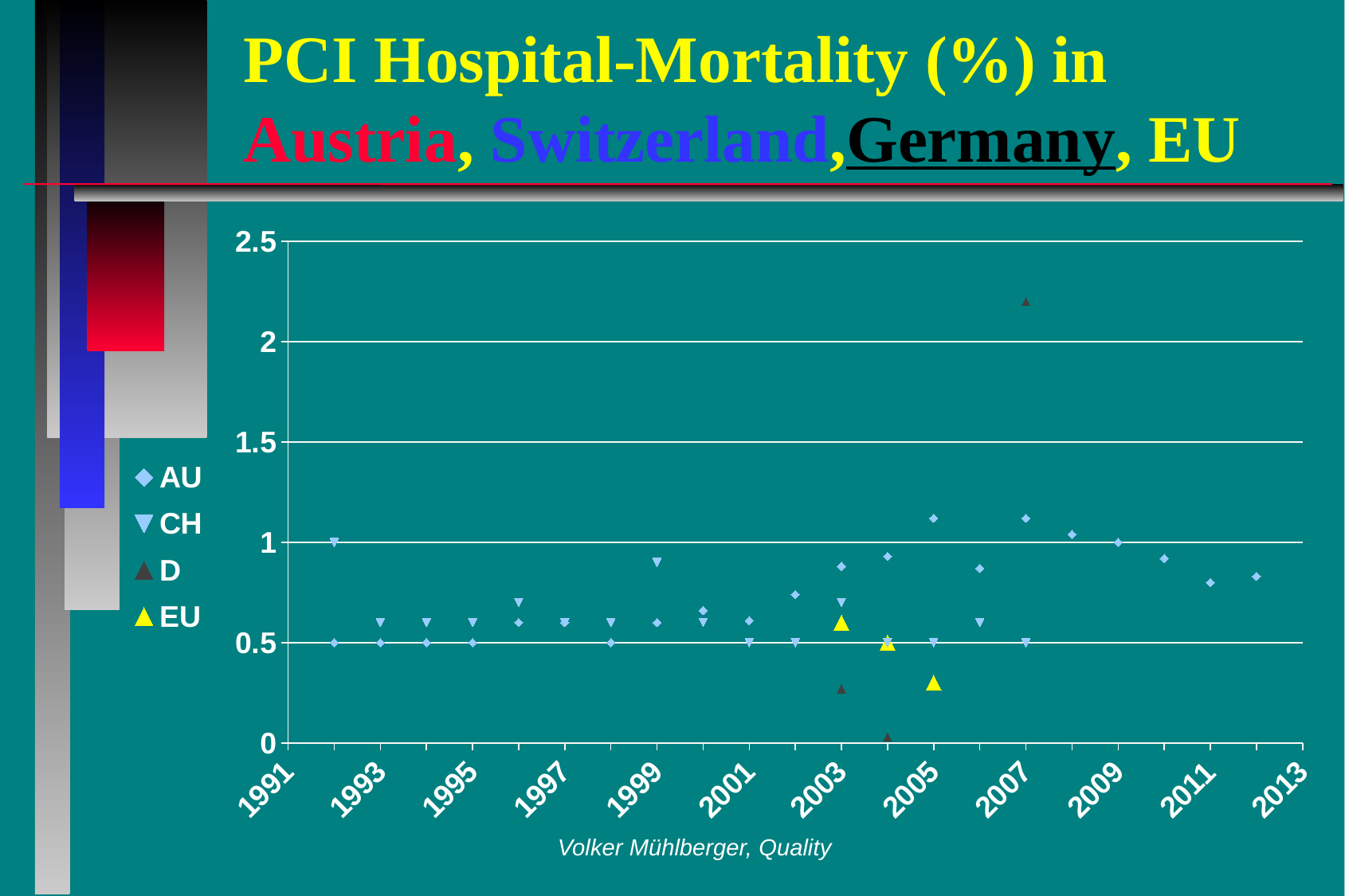
Which series has the highest point on the chart? D In 2007, which is higher, D or AU? D Which series are listed in the legend? AU, CH, D, EU In 2005, which is higher, AU or EU? AU What is the highest value shown on the y axis? 2.5 Is the value for EU in 2005 greater or less than 0.5? less What kind of chart is shown on the slide? scatter chart Is the value for AU in 2012 greater or less than 1? less How many series does the legend list? 4 Is the value for CH in 1999 greater or less than 0.5? greater